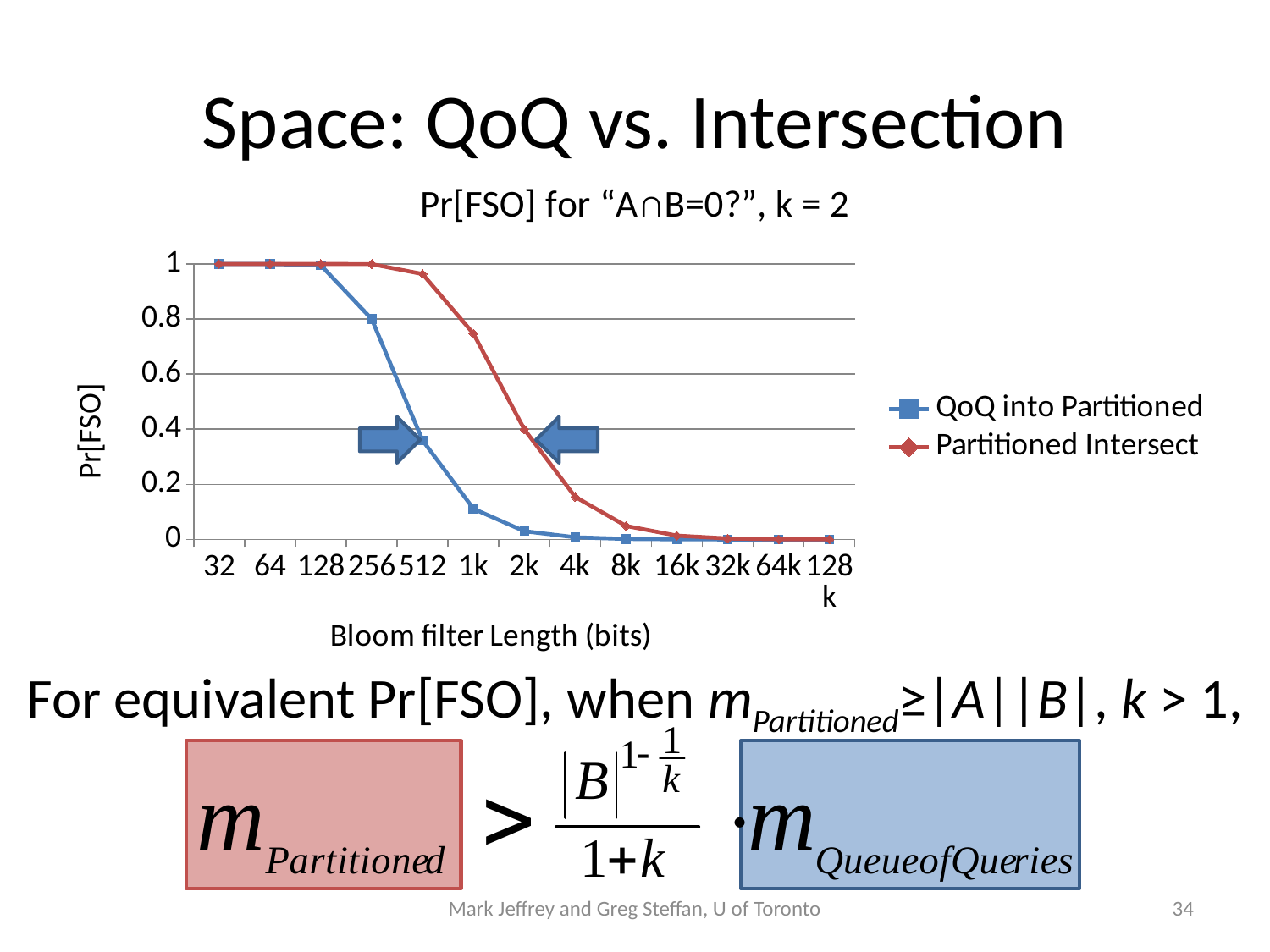
Is the Pr[FSO] value for Partitioned Intersect at 1k bits greater or less than 0.6? greater What kind of chart is shown on the slide? line chart At a Bloom filter length of 1k bits, which series has the larger Pr[FSO], QoQ into Partitioned or Partitioned Intersect? Partitioned Intersect What is the Pr[FSO] value for Partitioned Intersect at a Bloom filter length of 64 bits? 1 At a Bloom filter length of 512 bits, which series has the larger Pr[FSO], QoQ into Partitioned or Partitioned Intersect? Partitioned Intersect How many Bloom filter length categories are shown on the x axis? 13 Do the Pr[FSO] values rise or fall as the Bloom filter length increases? fall What is the label of the x axis? Bloom filter Length (bits) What is the Pr[FSO] value for QoQ into Partitioned at a Bloom filter length of 32 bits? 1 What is the title of the chart? Pr[FSO] for "A∩B=0?", k = 2 How many series does the chart legend list? 2 Is the Pr[FSO] value for QoQ into Partitioned at 1k bits greater or less than 0.2? less